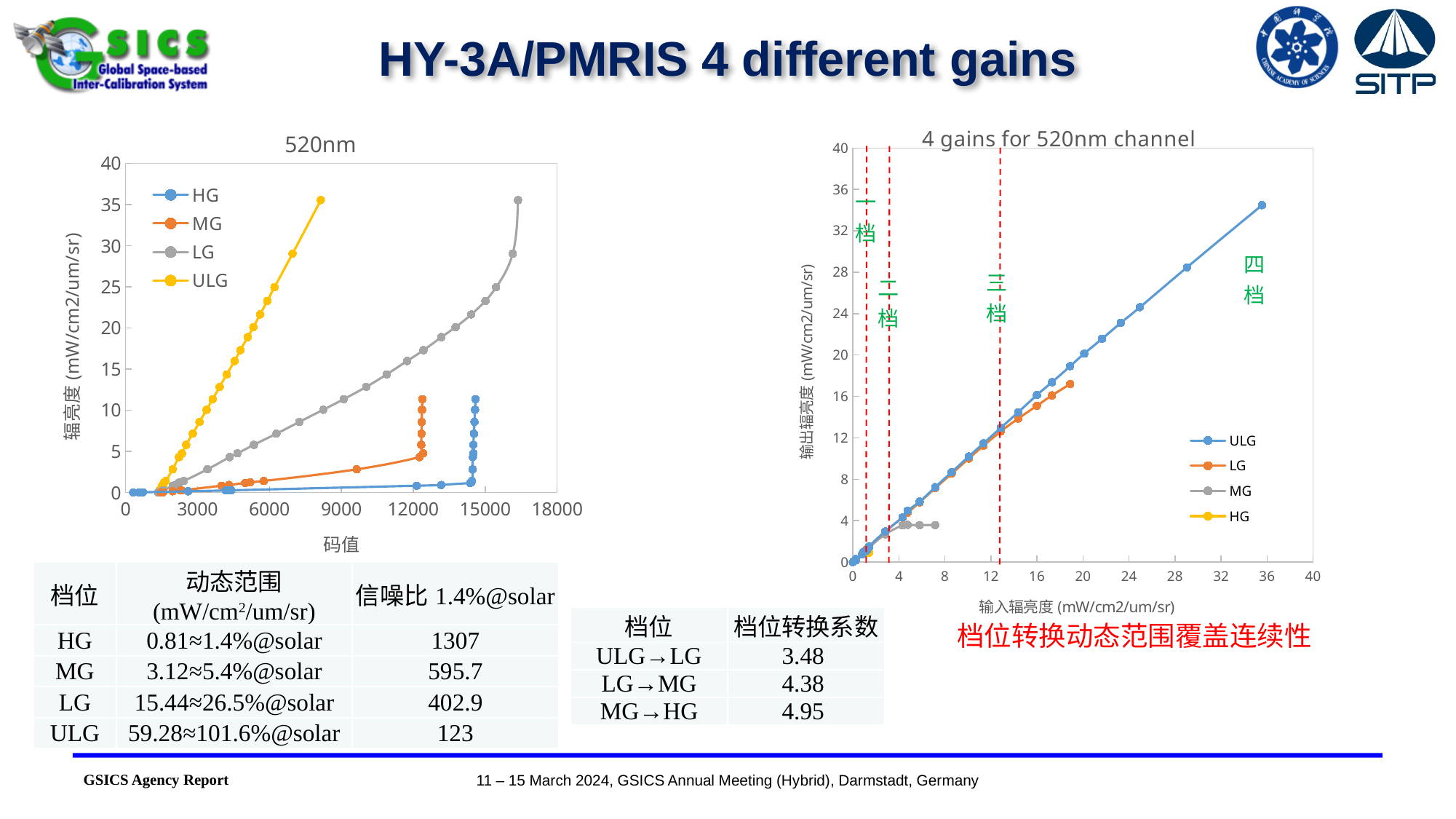
In the right chart titled "4 gains for 520nm channel", which series extends to the highest output radiance? ULG In the right chart titled "4 gains for 520nm channel", is the highest output radiance of the MG series greater or less than 8? less What kind of chart is the left chart titled "520nm"? line chart In the left chart titled "520nm", is the highest radiance reached by the ULG series greater or less than 30? greater How many series does the legend of the left chart titled "520nm" list? 4 In the right chart titled "4 gains for 520nm channel", is the highest output radiance of the LG series greater or less than 20? less In the left chart titled "520nm", at a code value of 6000, which series has the higher radiance, ULG or LG? ULG In the left chart titled "520nm", which series reaches a radiance of about 35 at the smallest code value (码值)? ULG What is the x-axis label of the right chart titled "4 gains for 520nm channel"? 输入辐亮度 (mW/cm2/um/sr) How many series does the legend of the right chart titled "4 gains for 520nm channel" list? 4 In the left chart titled "520nm", does the ULG series rise or fall as the code value increases? rise